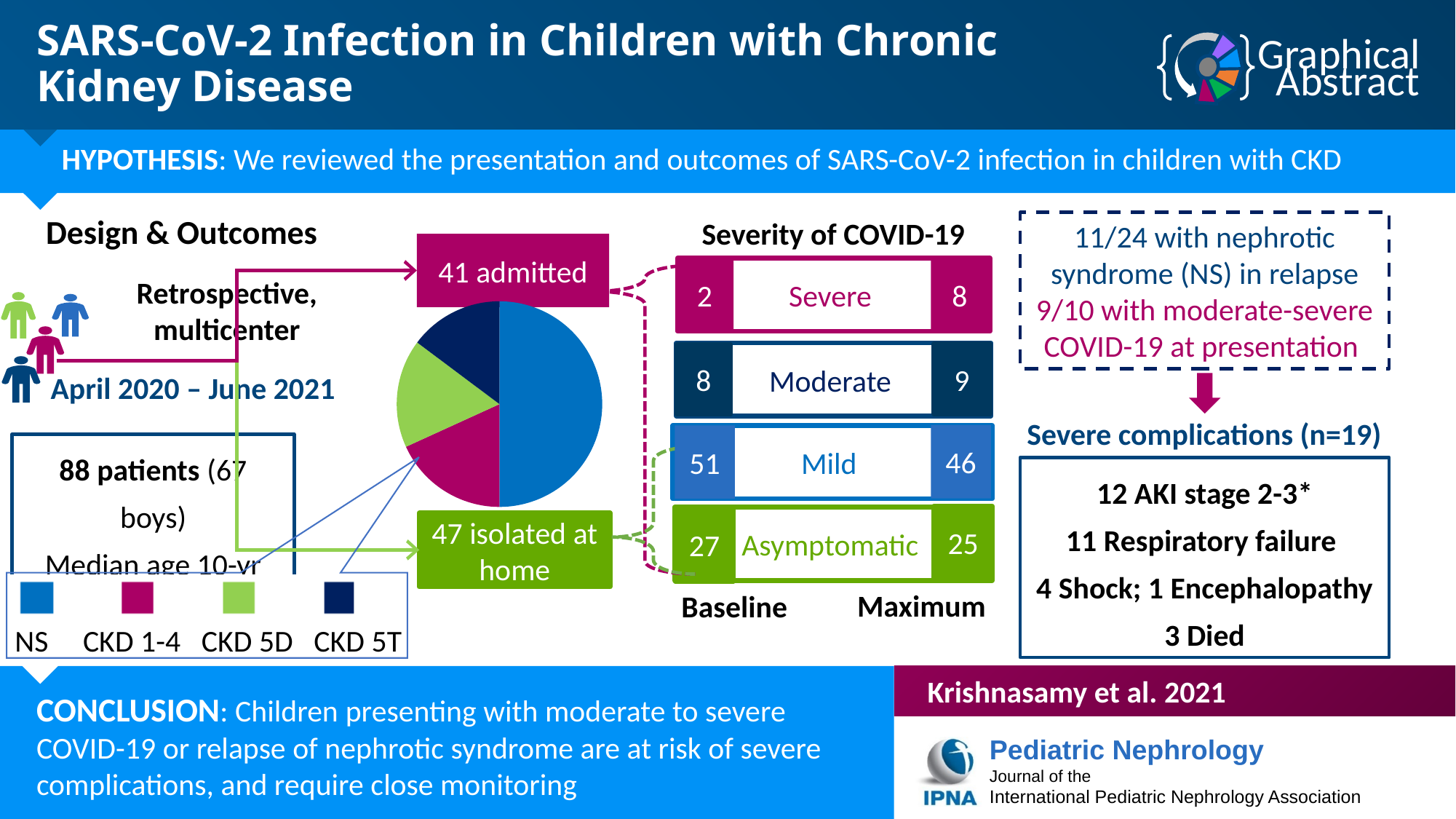
Which category has the largest slice of the pie chart? NS How many entries does the legend below the pie chart list? 4 How many slices does the pie chart have? 4 What colour represents NS in the pie chart legend? blue Which slice is larger in the pie chart, NS or CKD 5T? NS What kind of chart is shown in the centre of the slide under '41 admitted'? pie chart Which slice is larger in the pie chart, NS or CKD 5D? NS Which slice is larger in the pie chart, NS or CKD 1-4? NS Which category is shown in light green in the pie chart legend? CKD 5D